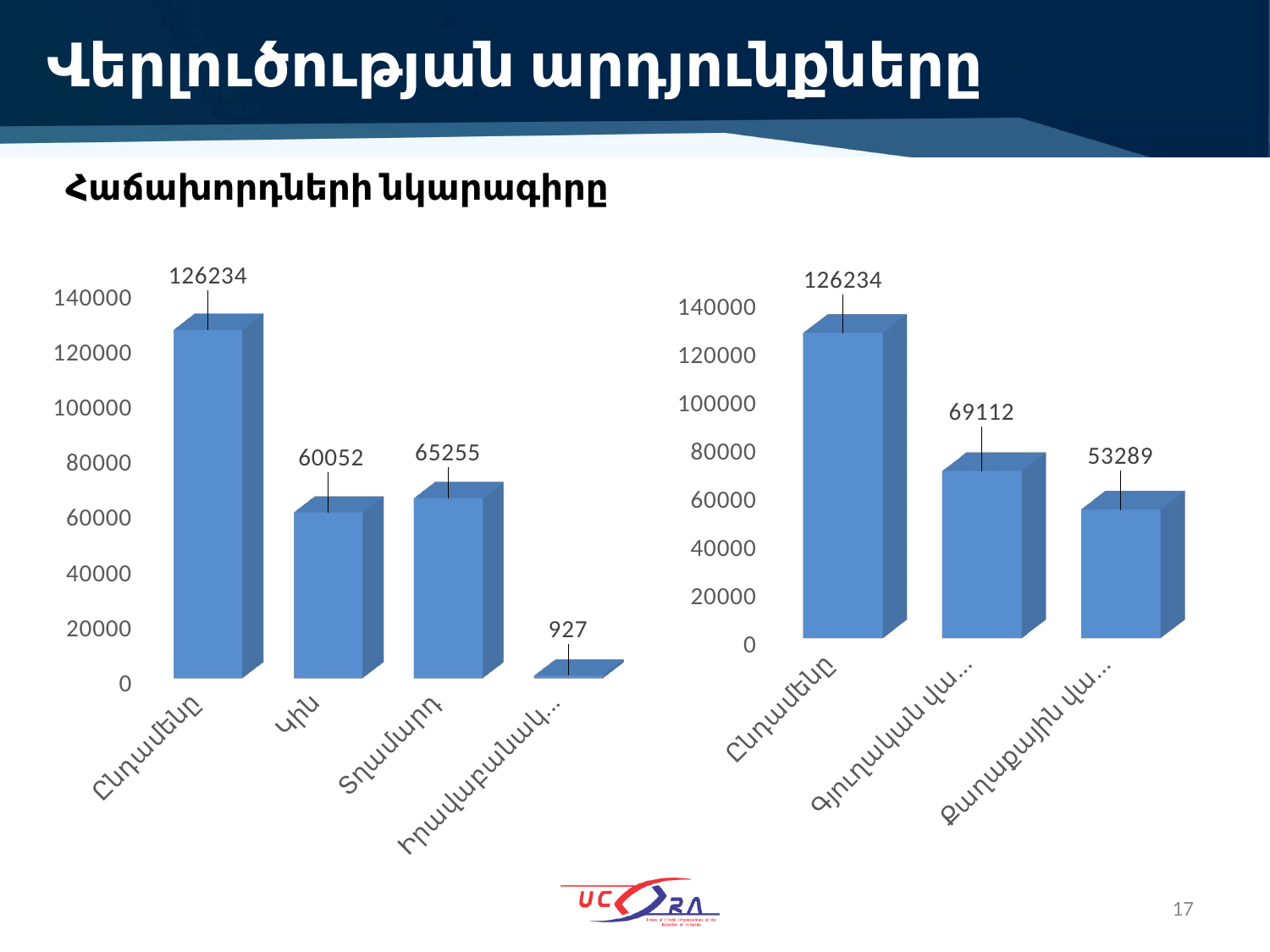
On the left chart, what is the difference between the values for Տղամարդ and Կին? 5203 On the right chart, what is the value for the category beginning with Գյուղական? 69112 On the left chart, which category has the lowest value? Իրավաբանակ… On the left chart, what is the value for Կին? 60052 How many bars does the left chart have? 4 On the right chart, what is the difference between the values for the Գյուղական and Քաղաքային categories? 15823 On the left chart, what is the value of the fourth (rightmost) bar? 927 What type of chart is the right chart? Bar chart On the left chart, what is the value for Տղամարդ? 65255 On the left chart, which is larger, the value for Կին or the value for Տղամարդ? Տղամարդ On the right chart, what is the value for the category beginning with Քաղաքային? 53289 On the right chart, which category has the highest value? Ընդամենը